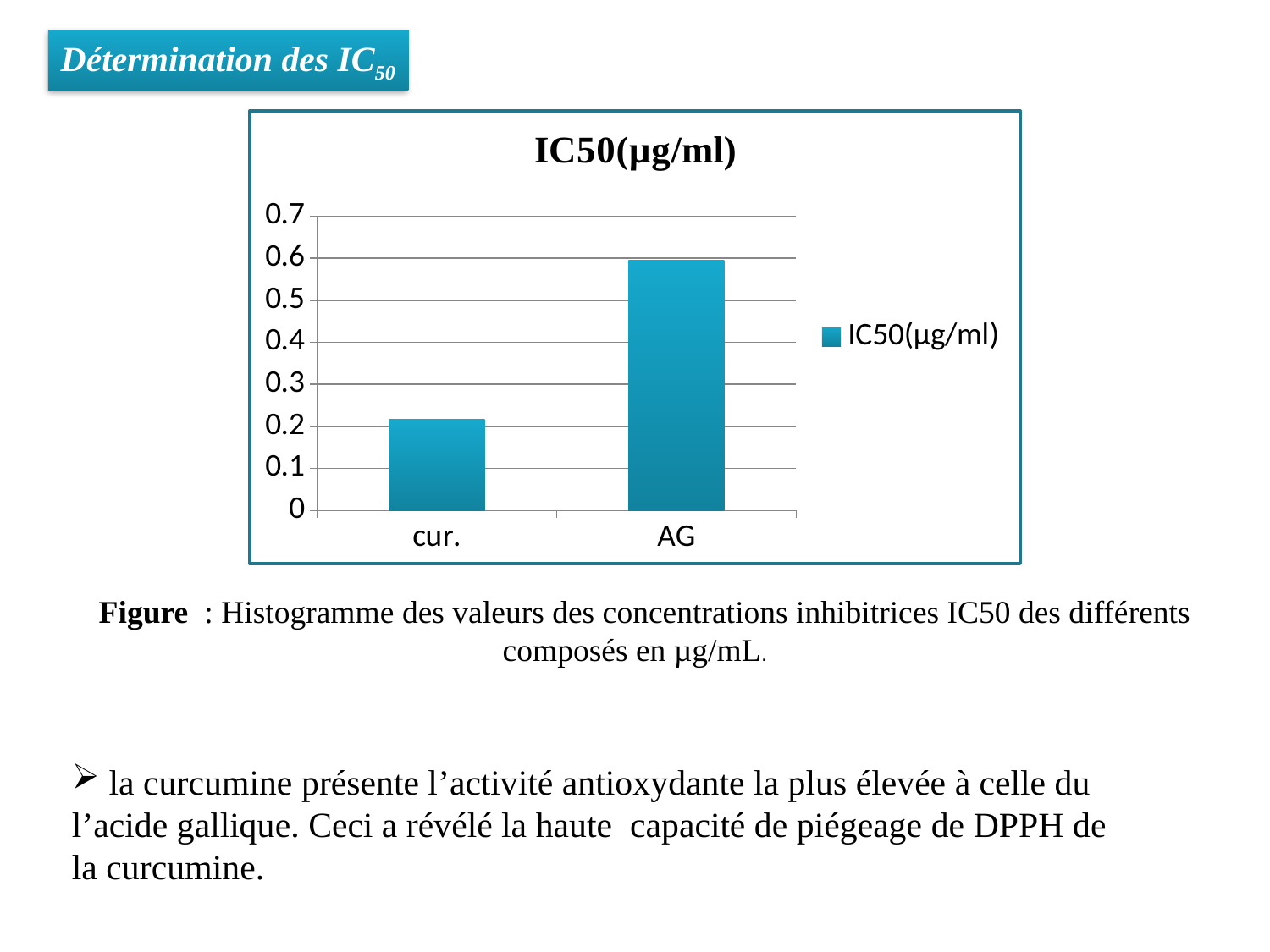
Which category has the highest IC50 value? AG Which has a larger IC50 value, cur. or AG? AG What kind of chart is shown on the slide? bar chart Is the IC50 value for cur. greater or less than 0.3? less What is the name of the series listed in the legend? IC50(µg/ml) How many categories are shown on the x axis of the chart? 2 Do the values rise or fall from cur. to AG along the x axis? rise Is the IC50 value for cur. greater or less than 0.1? greater What is the title of the chart? IC50(µg/ml) How many series does the legend list? 1 Is the IC50 value for AG greater or less than 0.5? greater Which category has the lowest IC50 value? cur.